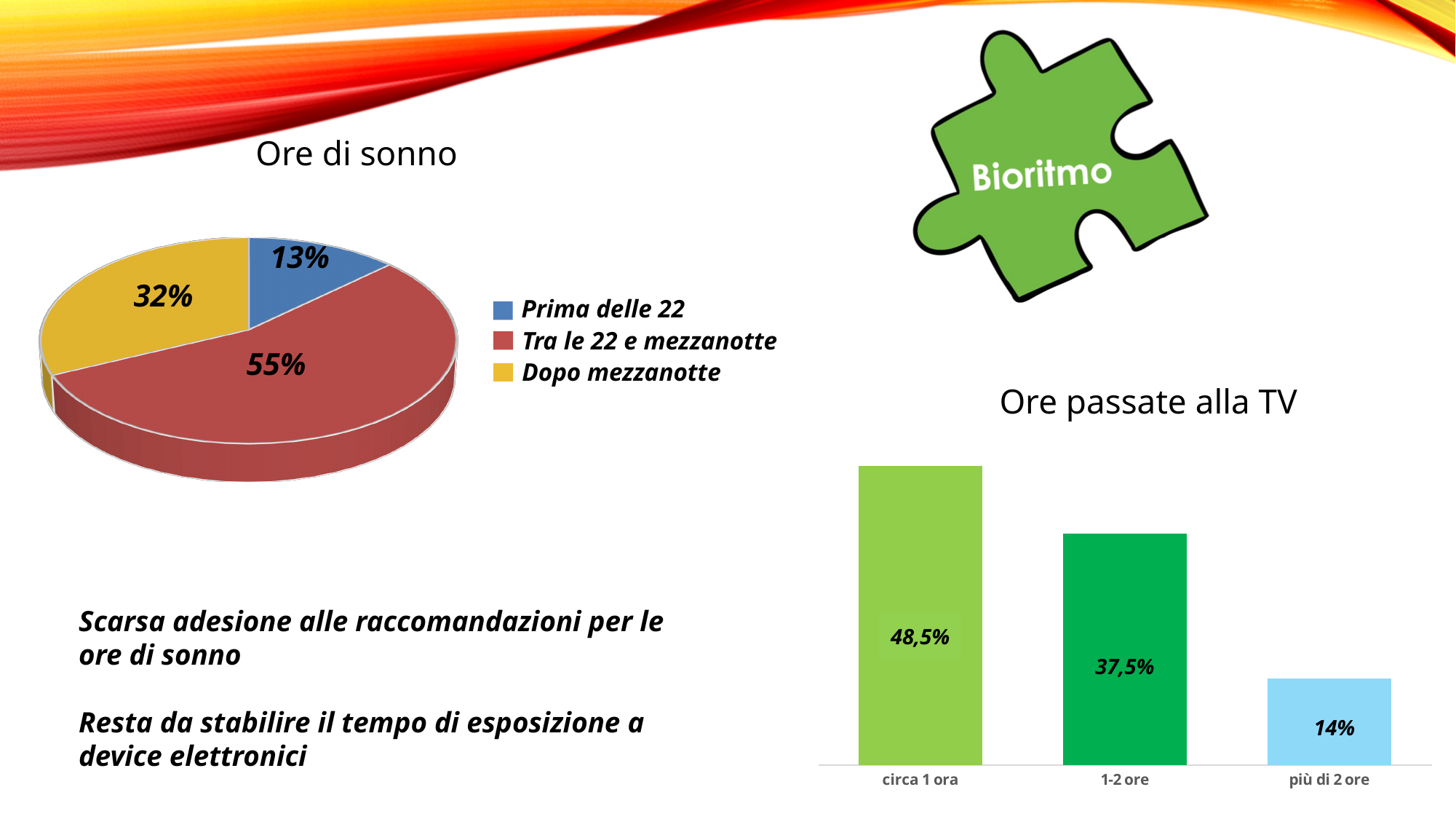
In the 'Ore di sonno' pie chart, how many categories does the legend list? 3 In the 'Ore di sonno' pie chart, what share is labelled for 'Tra le 22 e mezzanotte'? 55% In the 'Ore passate alla TV' chart, do the values rise or fall from left to right? Fall In the 'Ore passate alla TV' chart, what is the value for '1-2 ore'? 37,5% In the 'Ore passate alla TV' chart, which category has the highest value? circa 1 ora In the 'Ore di sonno' chart, what colour is the 'Dopo mezzanotte' slice? Yellow In the 'Ore passate alla TV' chart, what is the difference between 'circa 1 ora' and 'più di 2 ore'? 34,5% In the 'Ore di sonno' pie chart, what is the difference between the 'Dopo mezzanotte' and 'Prima delle 22' shares? 19% In the 'Ore di sonno' pie chart, which category has the largest slice? Tra le 22 e mezzanotte In the 'Ore di sonno' pie chart, which category has the smallest slice? Prima delle 22 What kind of chart is 'Ore passate alla TV'? Bar chart In the 'Ore di sonno' pie chart, what share is labelled for 'Prima delle 22'? 13%